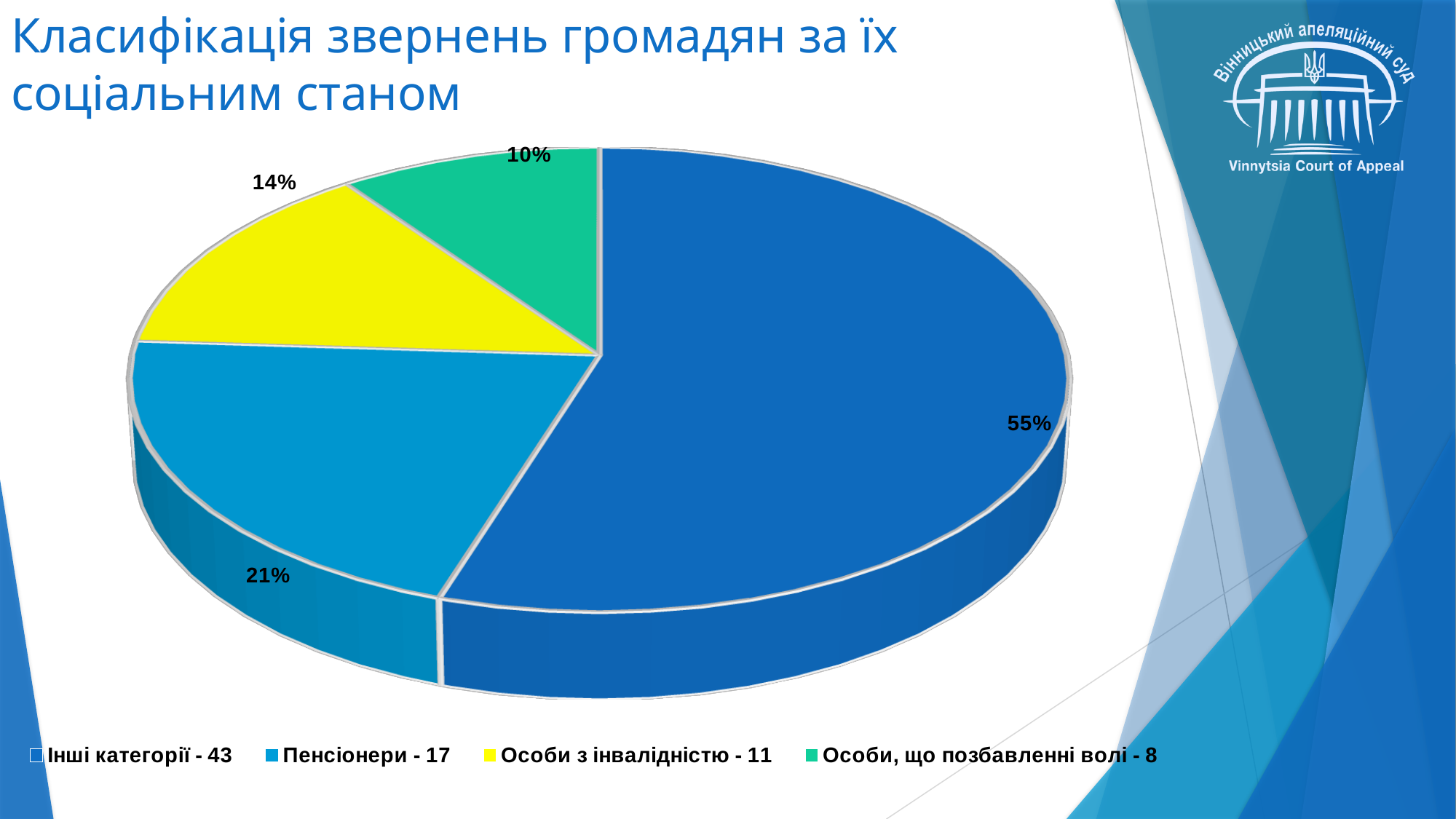
Which category has the largest slice of the pie? Інші категорії What percentage share does the slice for "Пенсіонери" have? 21% What kind of chart is shown on the slide? pie chart What percentage share does the slice for "Особи, що позбавленні волі" have? 10% How many slices does the pie chart have? 4 What colour is the slice for "Особи з інвалідністю"? yellow Which category has the smallest slice of the pie? Особи, що позбавленні волі What percentage share does the slice for "Особи з інвалідністю" have? 14% According to the legend, how many appeals are in the "Пенсіонери" category? 17 What is the difference in percentage points between the "Інші категорії" slice and the "Пенсіонери" slice? 34 Which slice is larger: "Особи з інвалідністю" or "Особи, що позбавленні волі"? Особи з інвалідністю